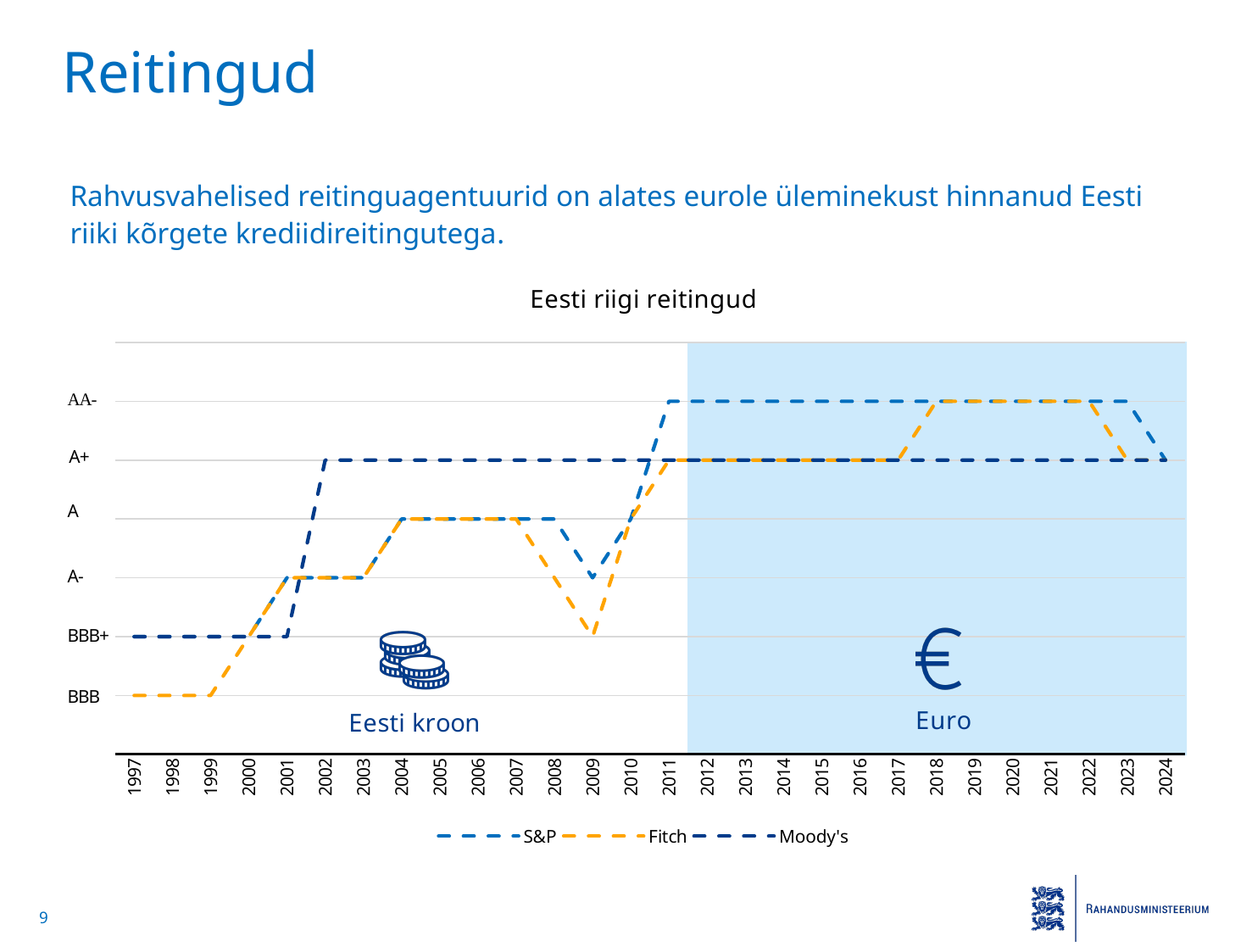
Which rating agencies are listed in the chart legend? S&P, Fitch, Moody's What rating does Fitch give in 2009? BBB+ How many years are shown on the x axis of the chart? 28 Does the Moody's rating rise or fall between 1997 and 2024? rise What rating does Fitch give in 1997? BBB What rating does Moody's give in 2024? A+ What rating does S&P give in 2024? A+ What kind of chart is shown on the slide? line chart How many series does the legend of the chart list? 3 What rating does S&P give in 2015? AA- What rating does Moody's give in 1997? BBB+ What is the title of the chart? Eesti riigi reitingud